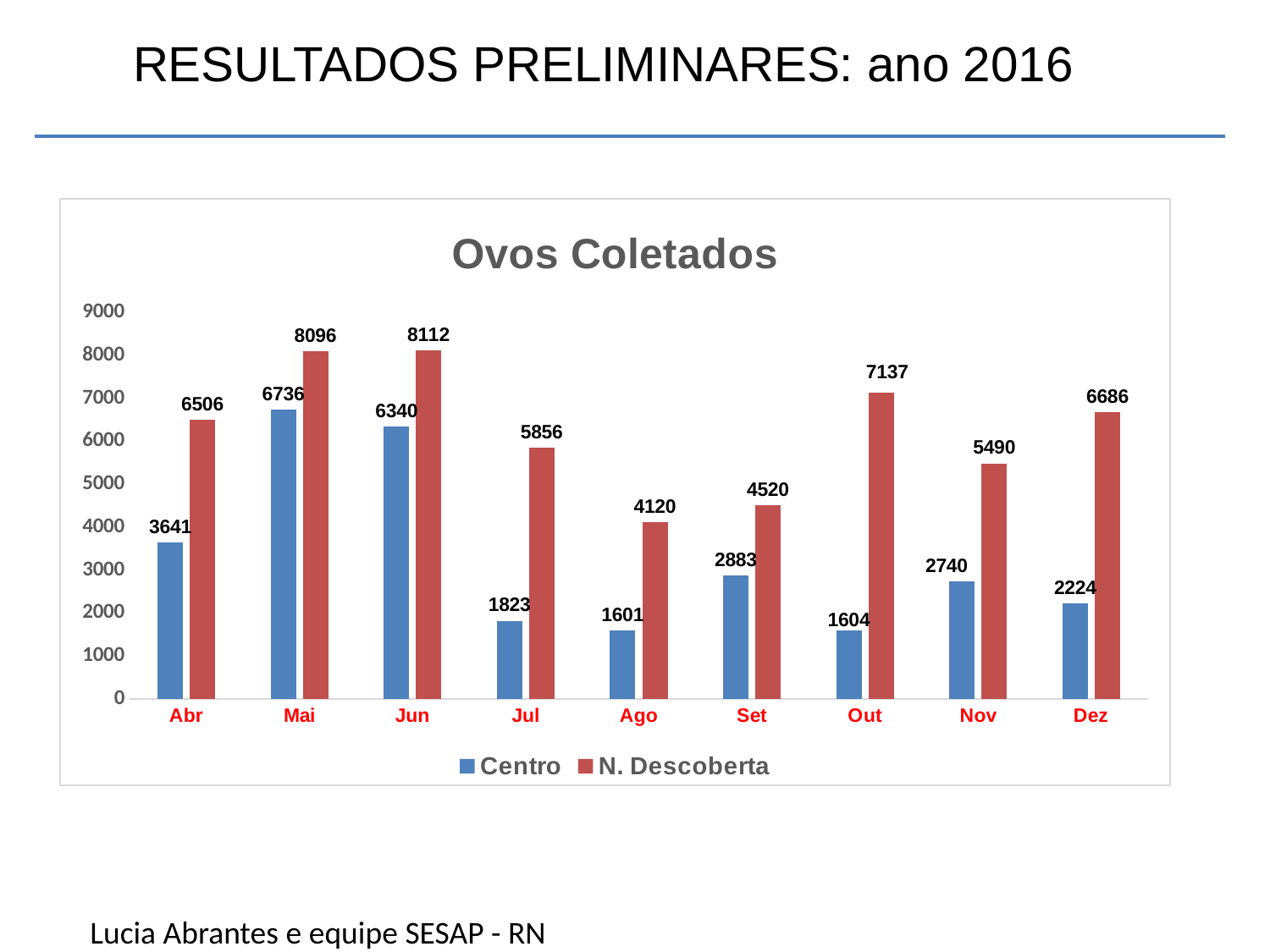
Which month has the lowest value for Centro? Ago What is the value for N. Descoberta in Out? 7137 Is the value for Centro in Jun greater or less than 6000? greater What colour are the bars for N. Descoberta? red How many series does the legend list? 2 Which month has the highest value for N. Descoberta? Jun What kind of chart is shown? bar chart What is the title of the chart? Ovos Coletados What is the difference between N. Descoberta and Centro in Mai? 1360 Which is larger in Set, Centro or N. Descoberta? N. Descoberta What is the value for Centro in Abr? 3641 How many months are shown on the x axis? 9